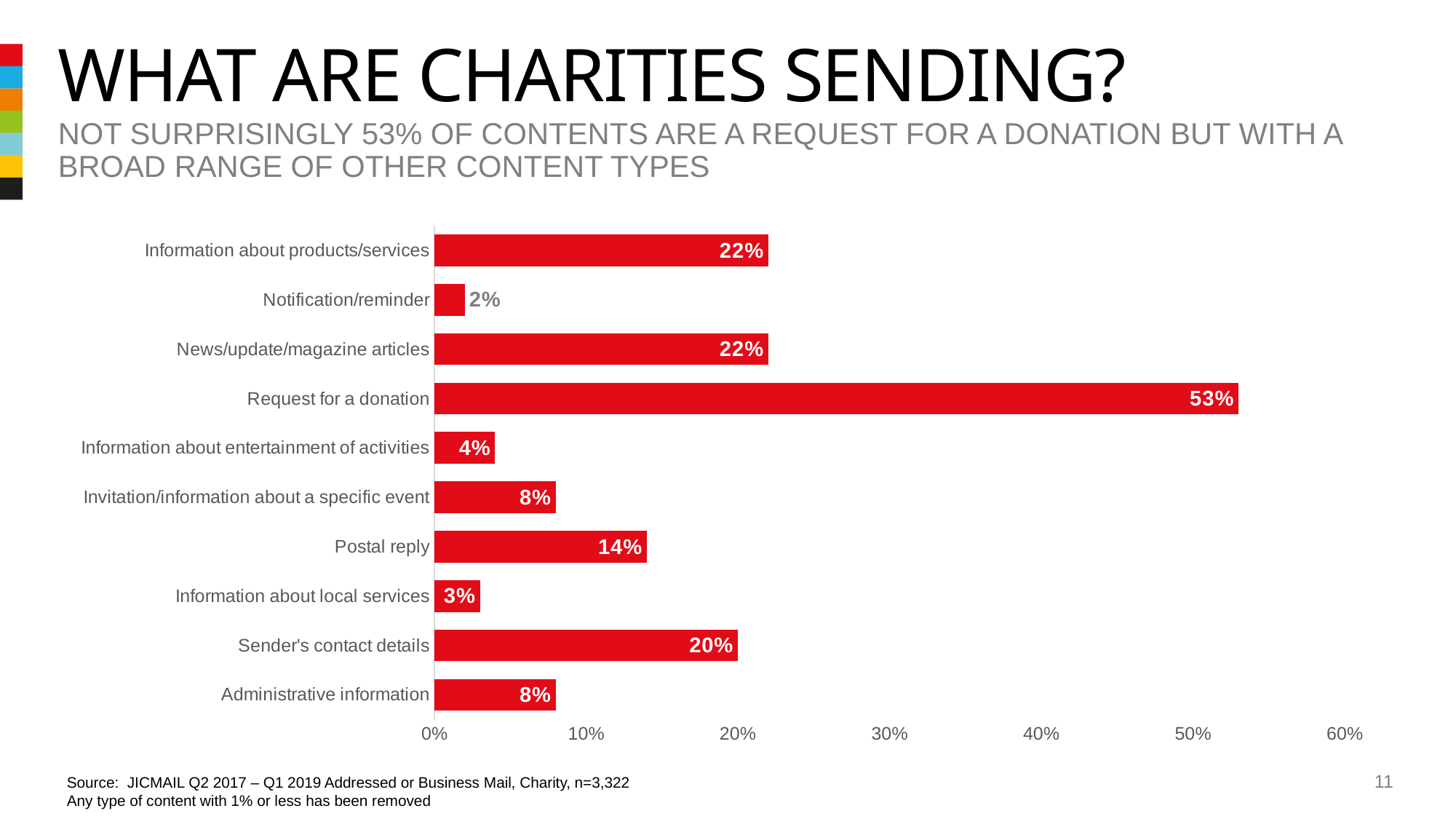
Which is larger, Postal reply or Invitation/information about a specific event? Postal reply What is the value for Request for a donation? 53% How many categories are shown in the chart? 10 Which category has the lowest value? Notification/reminder What is the value for Notification/reminder? 2% Which category has the highest value? Request for a donation Is the value for Request for a donation greater or less than 50%? greater What is the value for Sender's contact details? 20% What is the value for Postal reply? 14% What is the difference between Request for a donation and Sender's contact details? 33% What kind of chart is shown on the slide? bar chart What colour are the bars in the chart? red